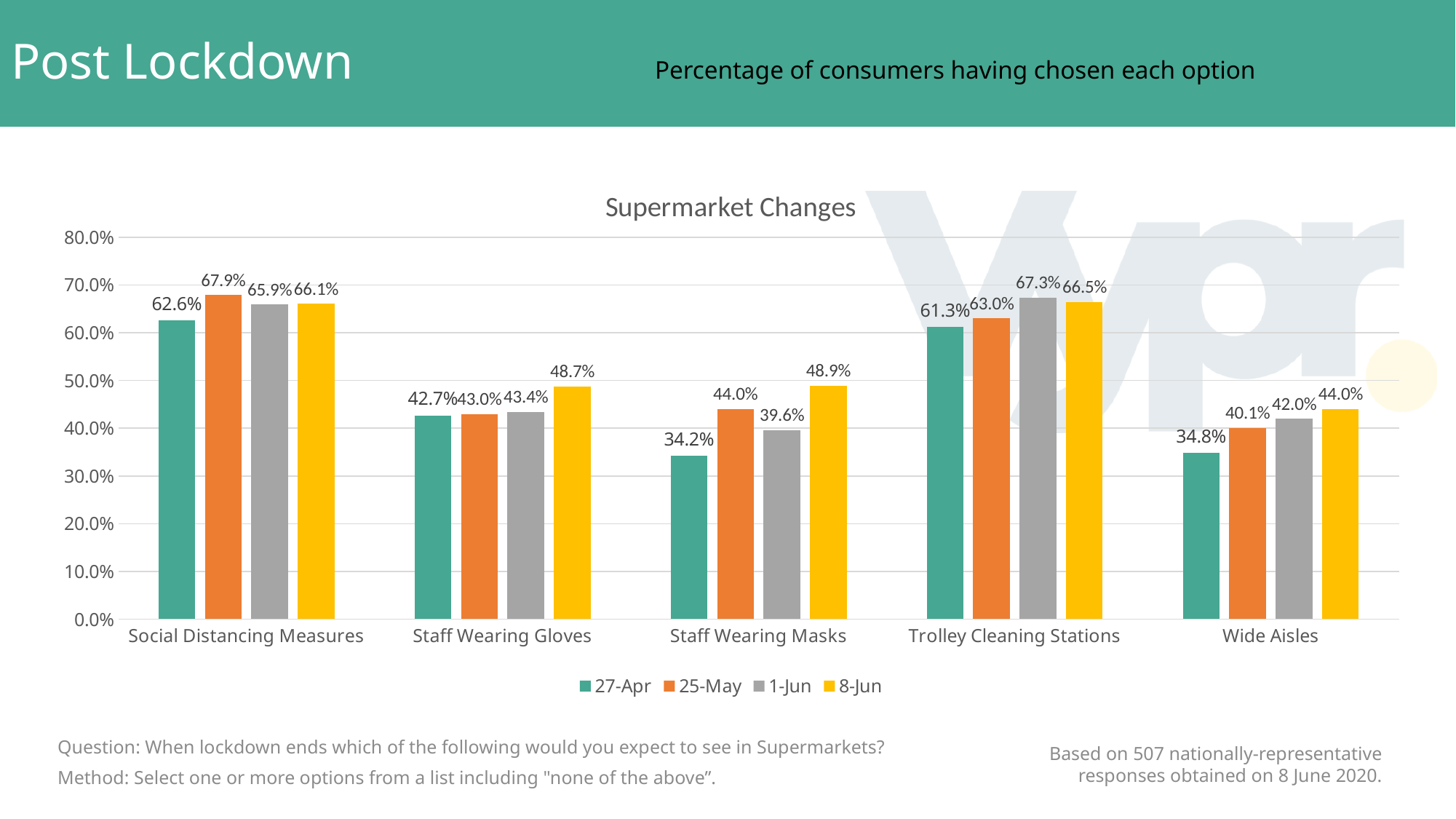
What is the value for Staff Wearing Masks in the 1-Jun series? 39.6% Which category has the lowest value in the 27-Apr series? Staff Wearing Masks Which category has the highest value in the 25-May series? Social Distancing Measures Is the 25-May value for Wide Aisles greater or less than 50.0%? less What kind of chart is shown on the slide? bar chart What is the value for Social Distancing Measures in the 27-Apr series? 62.6% Which is larger for Trolley Cleaning Stations: the 1-Jun value or the 8-Jun value? 1-Jun How many series does the legend list? 4 How many categories are shown on the x axis? 5 What is the value for Wide Aisles in the 8-Jun series? 44.0% What is the difference between the 8-Jun and 27-Apr values for Staff Wearing Masks? 14.7% What is the title of the chart? Supermarket Changes